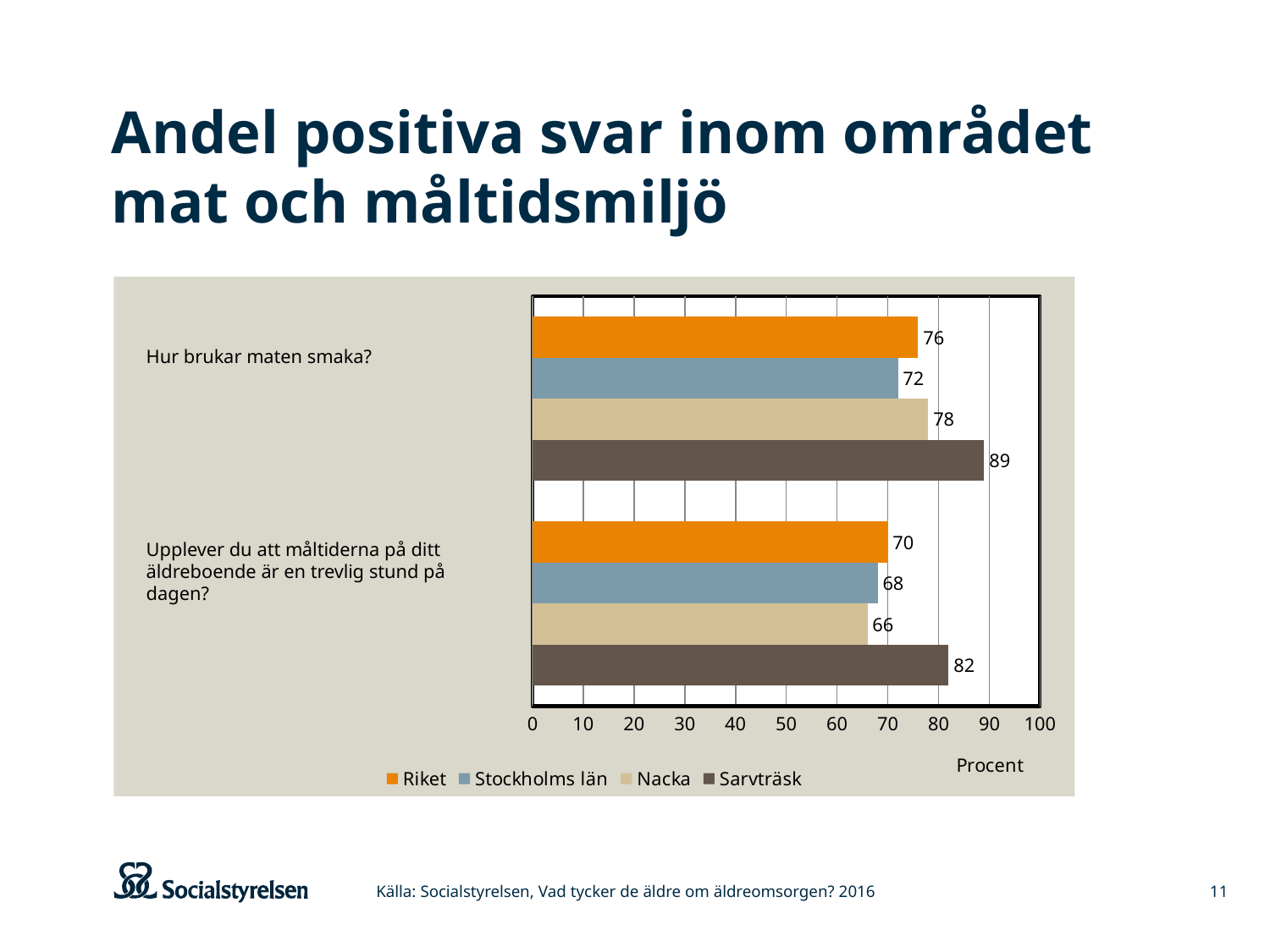
What is the value for Nacka on the question "Upplever du att måltiderna på ditt äldreboende är en trevlig stund på dagen?"? 66 What is the value for Sarvträsk on the question "Hur brukar maten smaka?"? 89 Which series has the highest value for "Hur brukar maten smaka?"? Sarvträsk What kind of chart is shown on the slide? Bar chart Which series has the lowest value for "Upplever du att måltiderna på ditt äldreboende är en trevlig stund på dagen?"? Nacka What is the value for Riket on the question "Hur brukar maten smaka?"? 76 Which is larger for "Hur brukar maten smaka?": Nacka or Stockholms län? Nacka How many series does the legend list? 4 What is the difference between Sarvträsk and Nacka on "Upplever du att måltiderna på ditt äldreboende är en trevlig stund på dagen?"? 16 What is the label on the horizontal axis of the chart? Procent What is the difference between Sarvträsk and Riket on "Hur brukar maten smaka?"? 13 What is the value for Stockholms län on the question "Upplever du att måltiderna på ditt äldreboende är en trevlig stund på dagen?"? 68